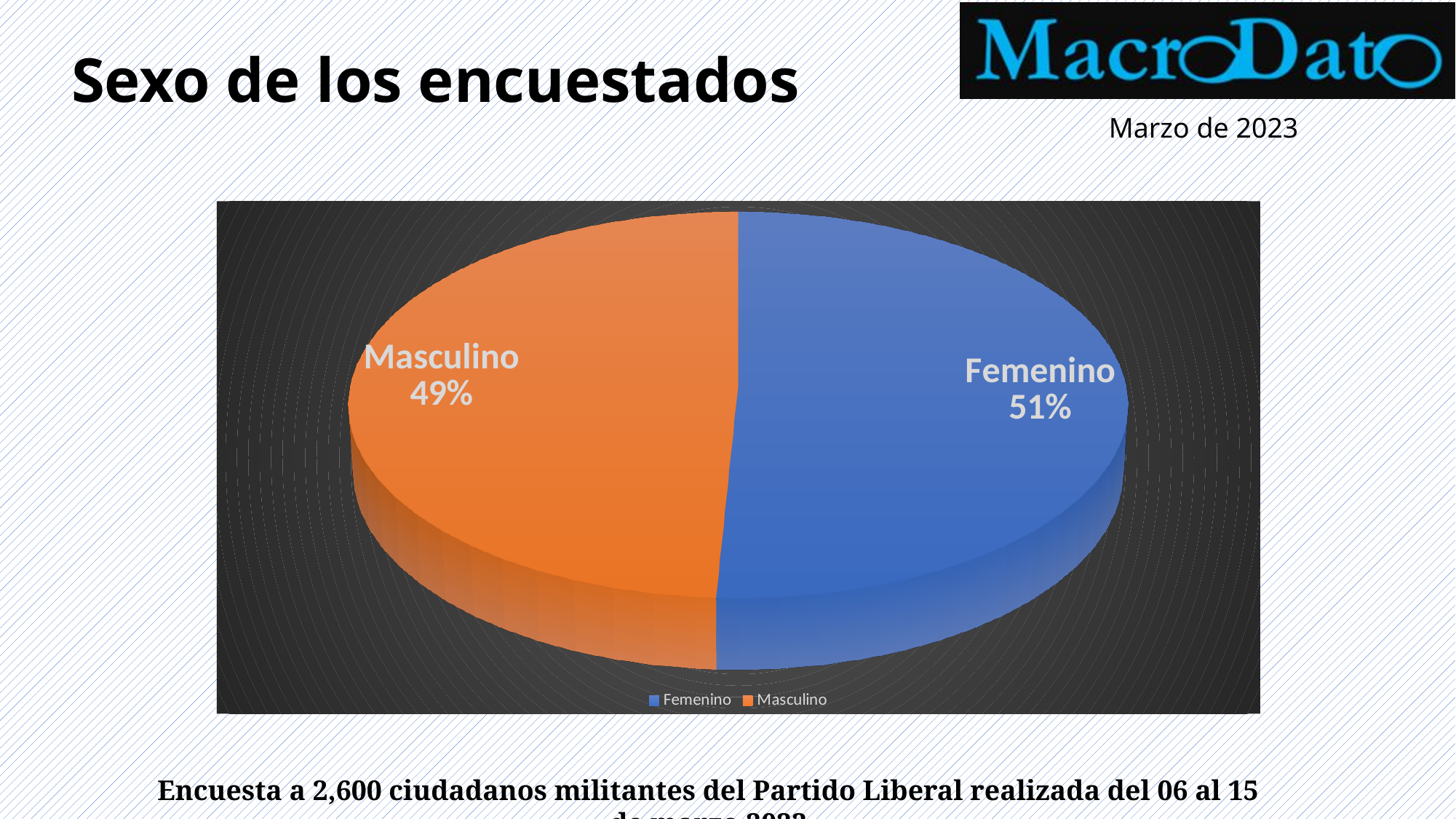
How many entries does the legend list? 2 What percentage of respondents are Masculino? 49% How many categories does the pie chart show? 2 What is the difference in percentage points between Femenino and Masculino? 2 Which category has the largest share of the pie? Femenino What percentage of respondents are Femenino? 51% Which category has the smallest share of the pie? Masculino What is the title of the slide? Sexo de los encuestados What kind of chart is shown on the slide? Pie chart Which is larger, the Femenino share or the Masculino share? Femenino What colour is the Masculino slice? Orange